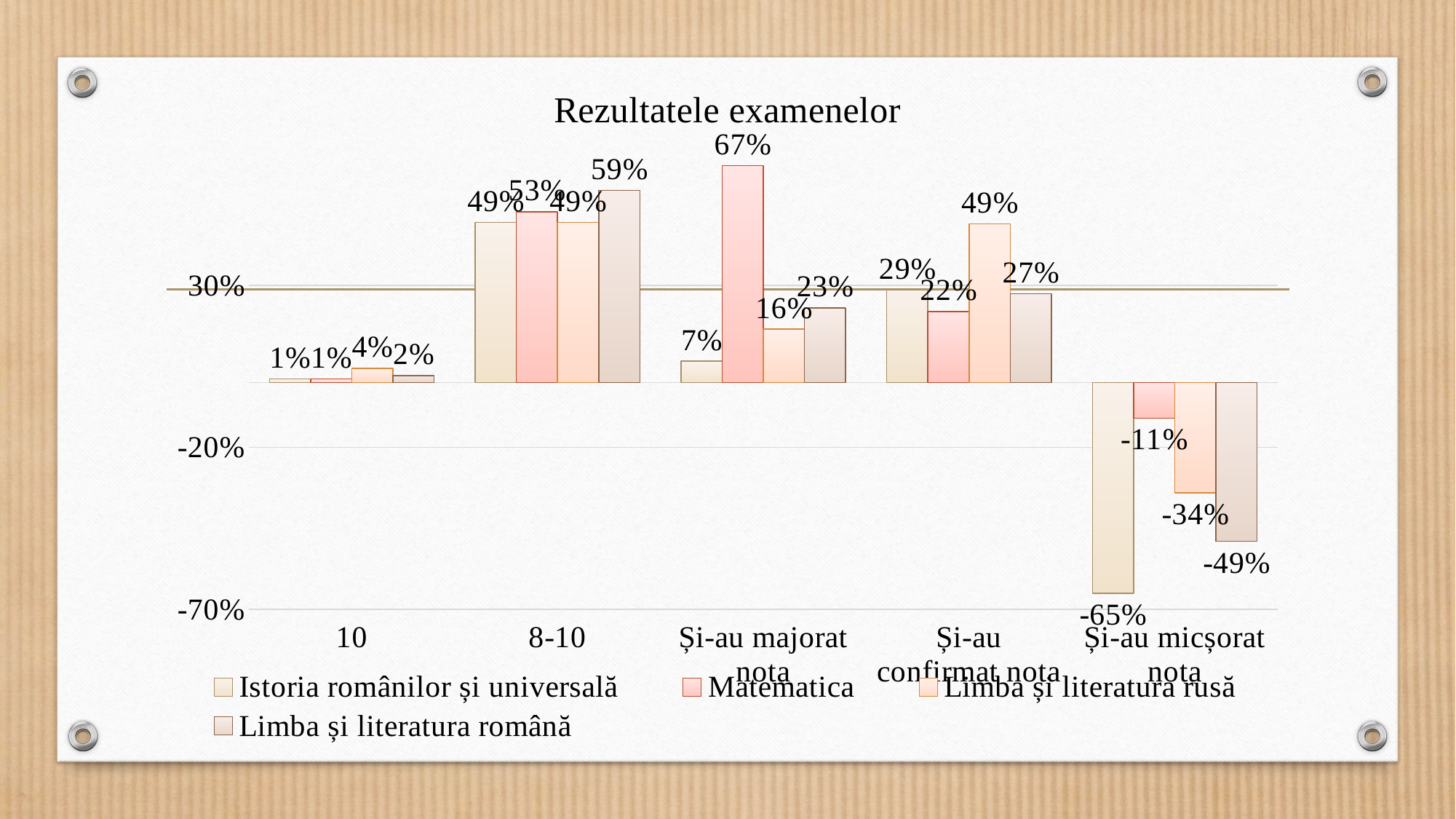
Which series has the highest value in the 'Și-au confirmat nota' category? Limba și literatura rusă What is the value for Istoria românilor și universală in the 'Și-au micșorat nota' category? -65% What kind of chart is shown on the slide? bar chart Which series has the lowest value in the 'Și-au majorat nota' category? Istoria românilor și universală What is the value for Limba și literatura română in the '8-10' category? 59% What is the title of the chart? Rezultatele examenelor In the '8-10' category, which is larger: the value for Matematica or the value for Limba și literatura rusă? Matematica How many categories are shown on the x axis? 5 What is the value for Matematica in the 'Și-au majorat nota' category? 67% What is the value for Limba și literatura rusă in the 'Și-au micșorat nota' category? -34% How many series does the legend list? 4 What is the difference between the Matematica and Istoria românilor și universală values in the 'Și-au majorat nota' category? 60%